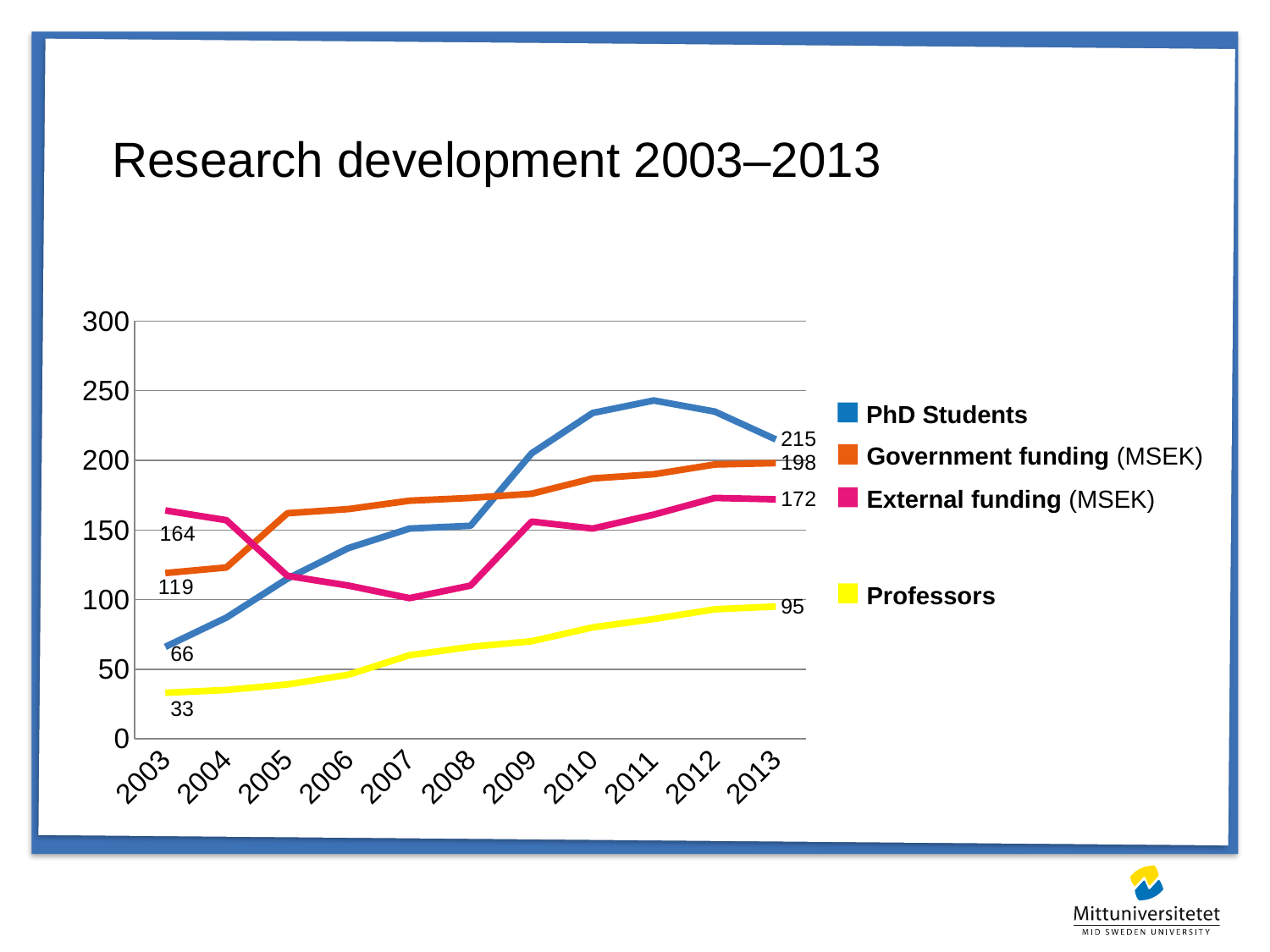
Which series has the highest value in 2013? PhD Students How many years are shown on the x axis? 11 What is the value for Professors in 2013? 95 What is the value for Government funding (MSEK) in 2003? 119 Which series has the lowest value in 2003? Professors Is the value for PhD Students in 2011 greater or less than 200? greater How many series does the legend list? 4 What kind of chart is shown on the slide? line chart What is the value for PhD Students in 2013? 215 What is the value for External funding (MSEK) in 2003? 164 How much did the number of PhD Students increase from 2003 to 2013? 149 What is the difference between Government funding and External funding in 2013? 26